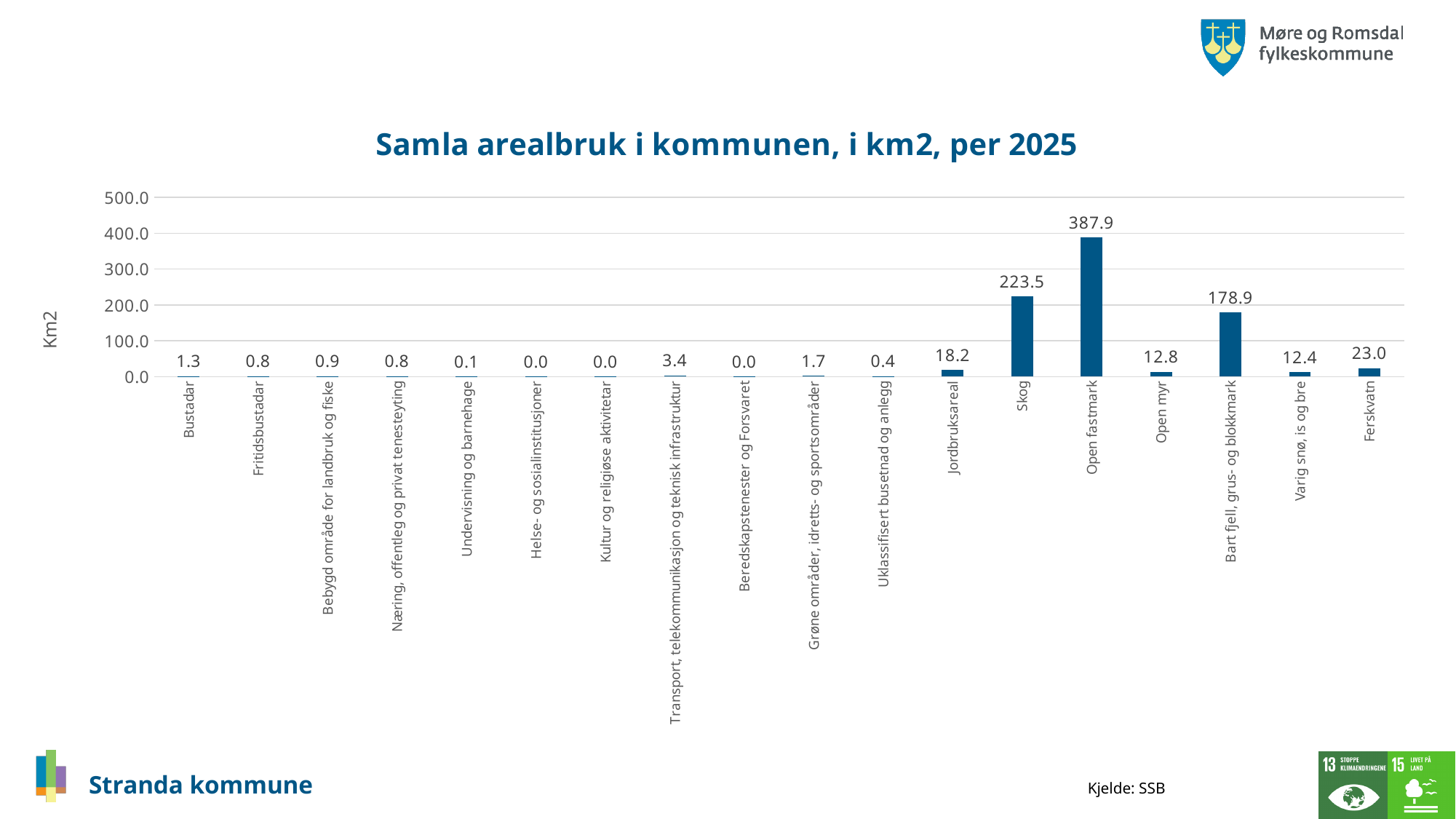
What is the value for Open fastmark? 387.9 Which category has the highest value? Open fastmark What is the value for Ferskvatn? 23.0 What kind of chart is shown on the slide? Bar chart How many categories are shown on the x axis? 18 Is the value for Bart fjell, grus- og blokkmark greater or less than 200.0? less Which is larger, the value for Open myr or the value for Ferskvatn? Ferskvatn What is the difference between the values for Open fastmark and Skog? 164.4 What is the difference between the values for Skog and Bart fjell, grus- og blokkmark? 44.6 What is the value for Jordbruksareal? 18.2 What is the title of the chart? Samla arealbruk i kommunen, i km2, per 2025 What is the value for Skog? 223.5